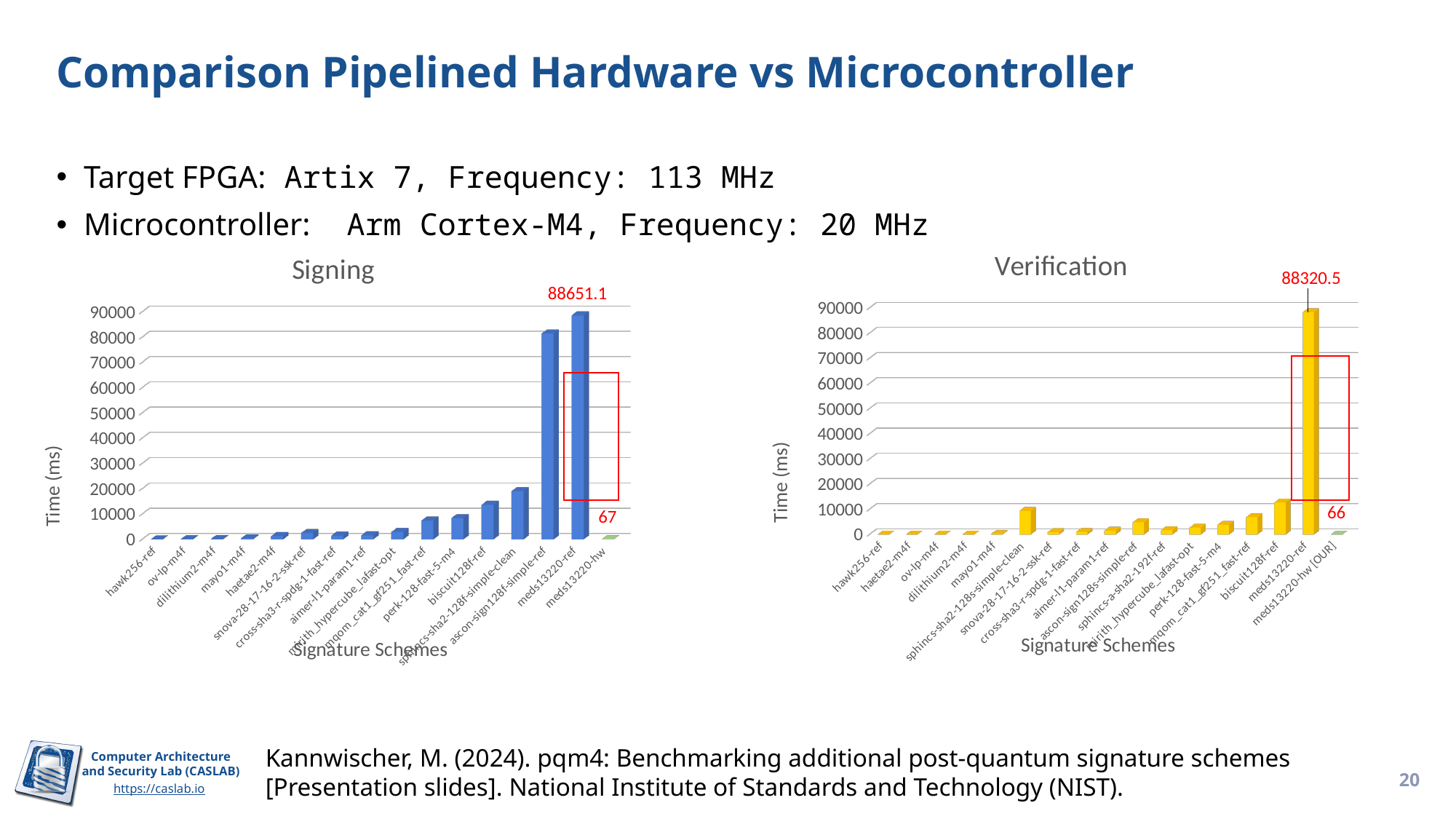
In the Signing chart, which signature scheme has the highest time? meds13220-ref In the Verification chart, what is the time in ms for meds13220-ref? 88320.5 What kind of chart is the Verification chart? bar chart In the Signing chart, what is the time in ms for meds13220-hw? 67 In the Signing chart, which has a larger time, meds13220-ref or meds13220-hw? meds13220-ref In the Verification chart, what is the time in ms for meds13220-hw [OUR]? 66 In the Verification chart, what is the difference in time between meds13220-ref and meds13220-hw [OUR]? 88254.5 In the Verification chart, which signature scheme has the highest time? meds13220-ref In the Signing chart, what is the time in ms for meds13220-ref? 88651.1 In the Signing chart, is the value for ascon-sign128f-simple-ref greater or less than 70000? greater In the Signing chart, what is the difference in time between meds13220-ref and meds13220-hw? 88584.1